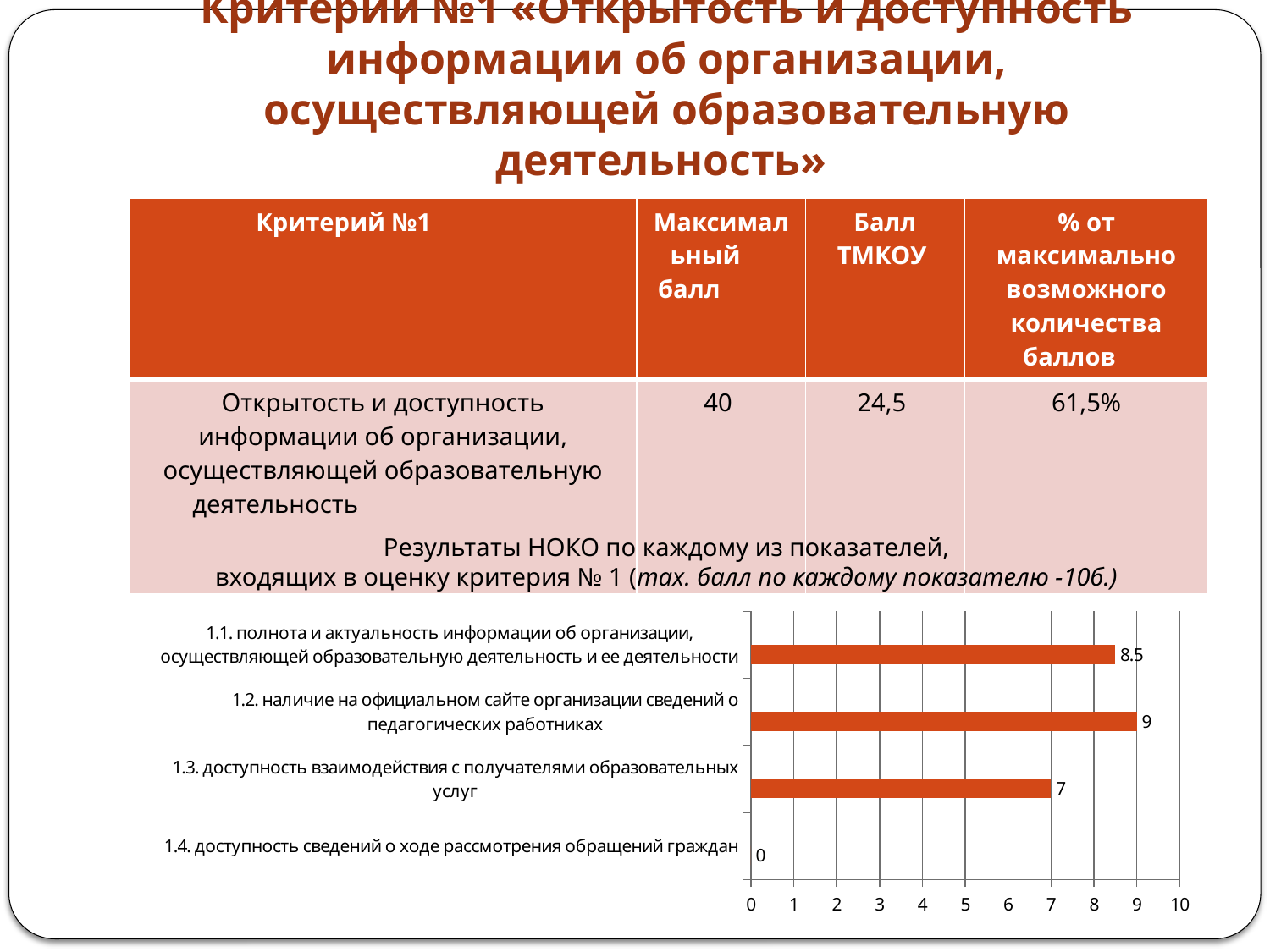
What is the value for indicator 1.3 (доступность взаимодействия с получателями образовательных услуг)? 7 Which indicator has the highest value in the chart? 1.2. наличие на официальном сайте организации сведений о педагогических работниках Which indicator has the lowest value in the chart? 1.4. доступность сведений о ходе рассмотрения обращений граждан What is the difference between the values for indicator 1.2 and indicator 1.1? 0.5 What is the difference between the values for indicator 1.2 and indicator 1.3? 2 What is the maximum value shown on the chart's horizontal axis? 10 What kind of chart is shown on the slide? Bar chart How many indicators (categories) are shown in the chart? 4 What is the value for indicator 1.1 (полнота и актуальность информации об организации)? 8.5 What is the value for indicator 1.2 (наличие на официальном сайте организации сведений о педагогических работниках)? 9 Which has a larger value, indicator 1.1 or indicator 1.3? 1.1 What is the value for indicator 1.4 (доступность сведений о ходе рассмотрения обращений граждан)? 0